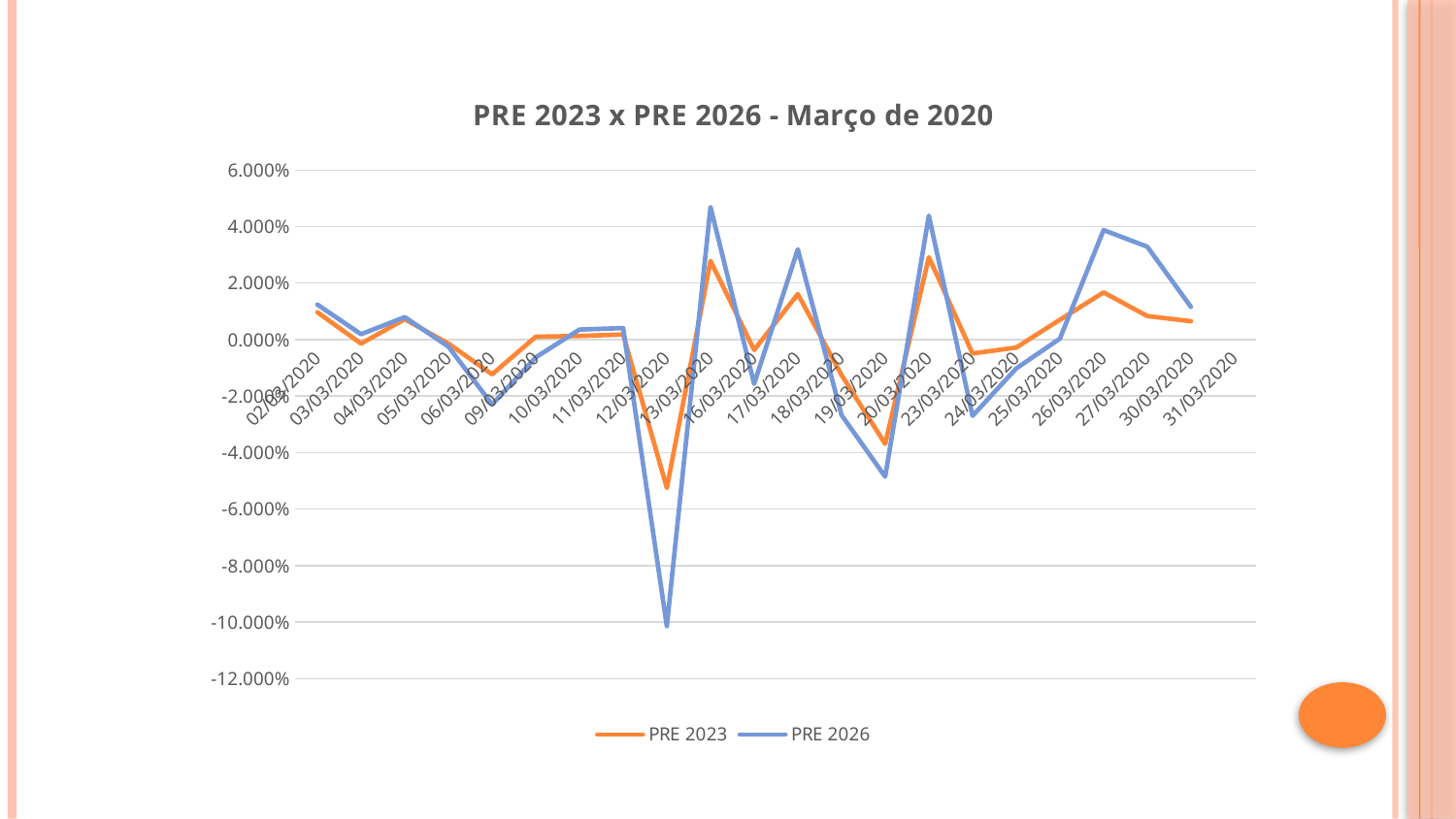
Is the value for PRE 2026 on 26/03/2020 greater or less than 2.000%? greater What kind of chart is shown on the slide? Line chart How many series does the legend list? 2 Which colour is used for the PRE 2023 line? Orange On 13/03/2020, which series has the higher value, PRE 2023 or PRE 2026? PRE 2026 Is the value for PRE 2026 on 12/03/2020 greater or less than -8.000%? less How many dates are plotted along the x axis? 22 Is the value for PRE 2023 on 12/03/2020 greater or less than -4.000%? less On which date does the PRE 2026 series reach its lowest value? 12/03/2020 What is the title of the chart? PRE 2023 x PRE 2026 - Março de 2020 On which date does the PRE 2023 series reach its lowest value? 12/03/2020